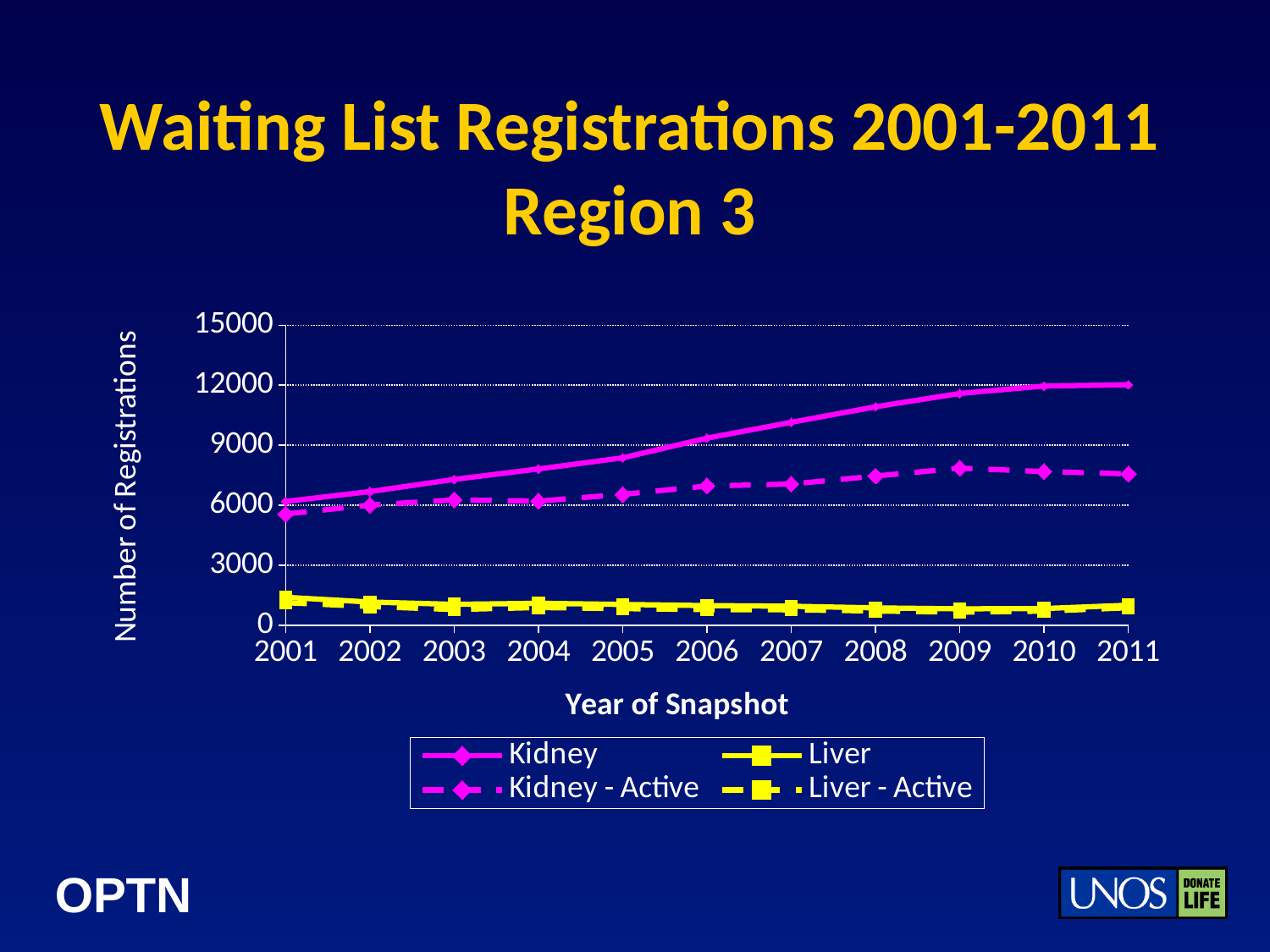
Is the value for Kidney - Active in 2009 greater or less than 9000? less What kind of chart is shown on the slide? line chart Is the value for Kidney in 2008 greater or less than 9000? greater How many series does the legend list? 4 In 2011, which is larger, Kidney or Kidney - Active? Kidney How many years are plotted along the x axis? 11 Is the value for Liver in 2001 greater or less than 3000? less In which year is the Kidney series at its lowest? 2001 In 2011, which is larger, Kidney or Liver? Kidney What is the label of the y axis? Number of Registrations Does the Kidney series rise or fall from 2001 to 2011? rise